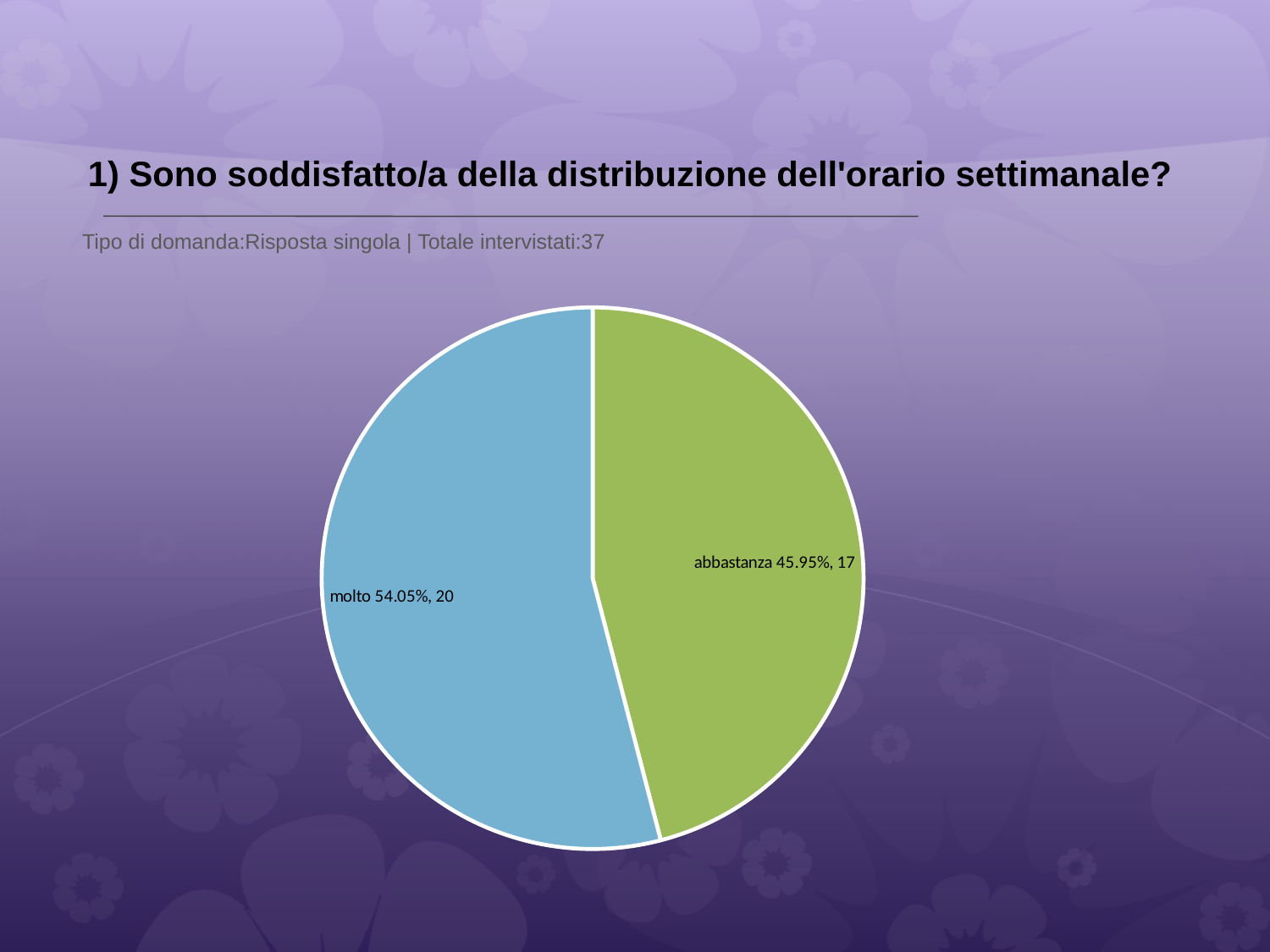
What is the total number of respondents across both slices? 37 Which slice is the smallest? abbastanza What percentage share does the 'abbastanza' slice have? 45.95% How many respondents answered 'molto'? 20 What is the difference in respondent count between 'molto' and 'abbastanza'? 3 What colour is the 'abbastanza' slice? green Which has more respondents, 'molto' or 'abbastanza'? molto What percentage share does the 'molto' slice have? 54.05% How many slices does the pie chart have? 2 How many respondents answered 'abbastanza'? 17 What kind of chart is shown on the slide? pie chart Which slice is the largest? molto